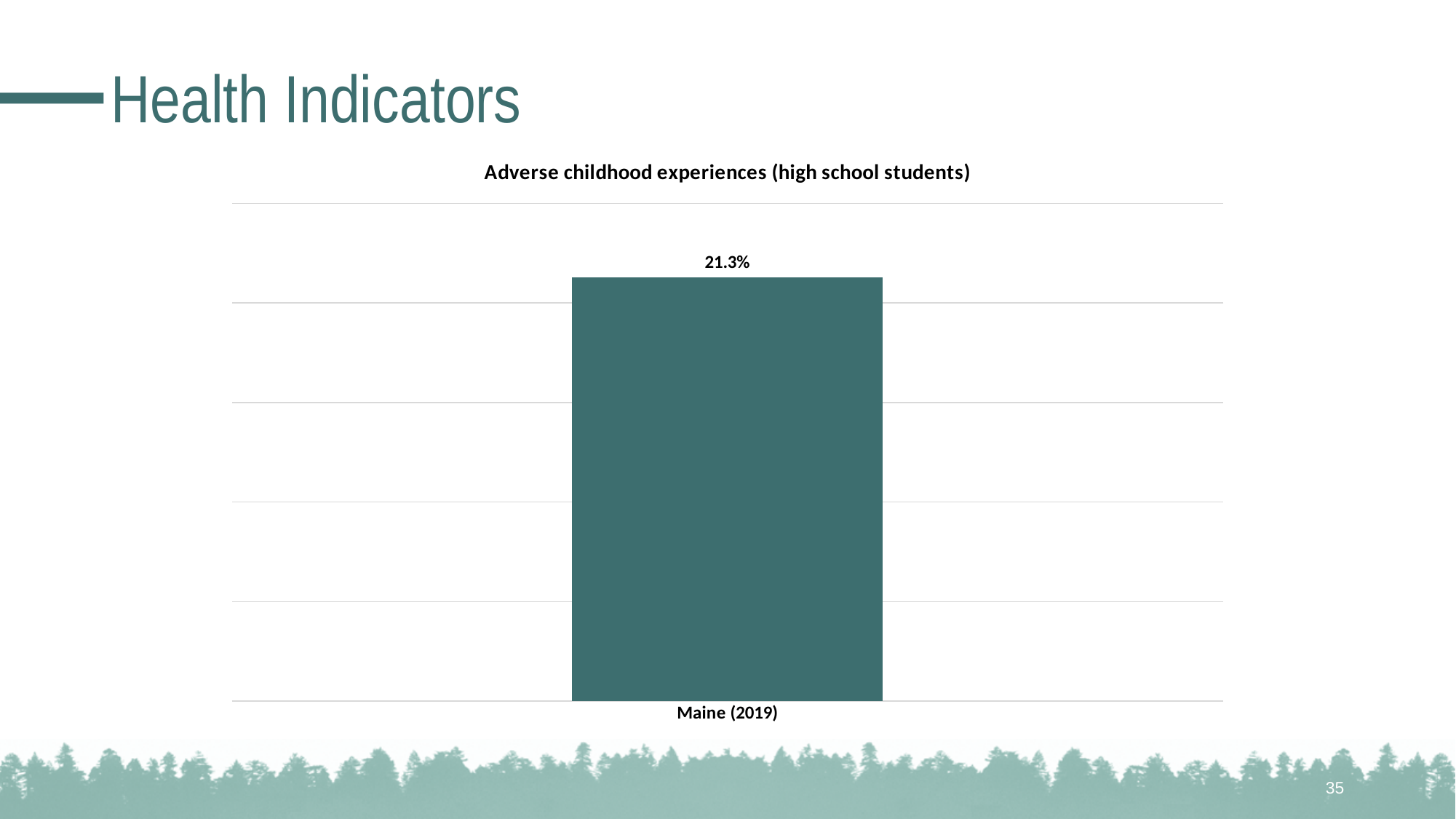
What is the value for Maine (2019) in the chart? 21.3% What is the title of the chart? Adverse childhood experiences (high school students) Which category is shown on the x axis of the chart? Maine (2019) How many categories are plotted in the chart? 1 What kind of chart is shown on the slide? bar chart